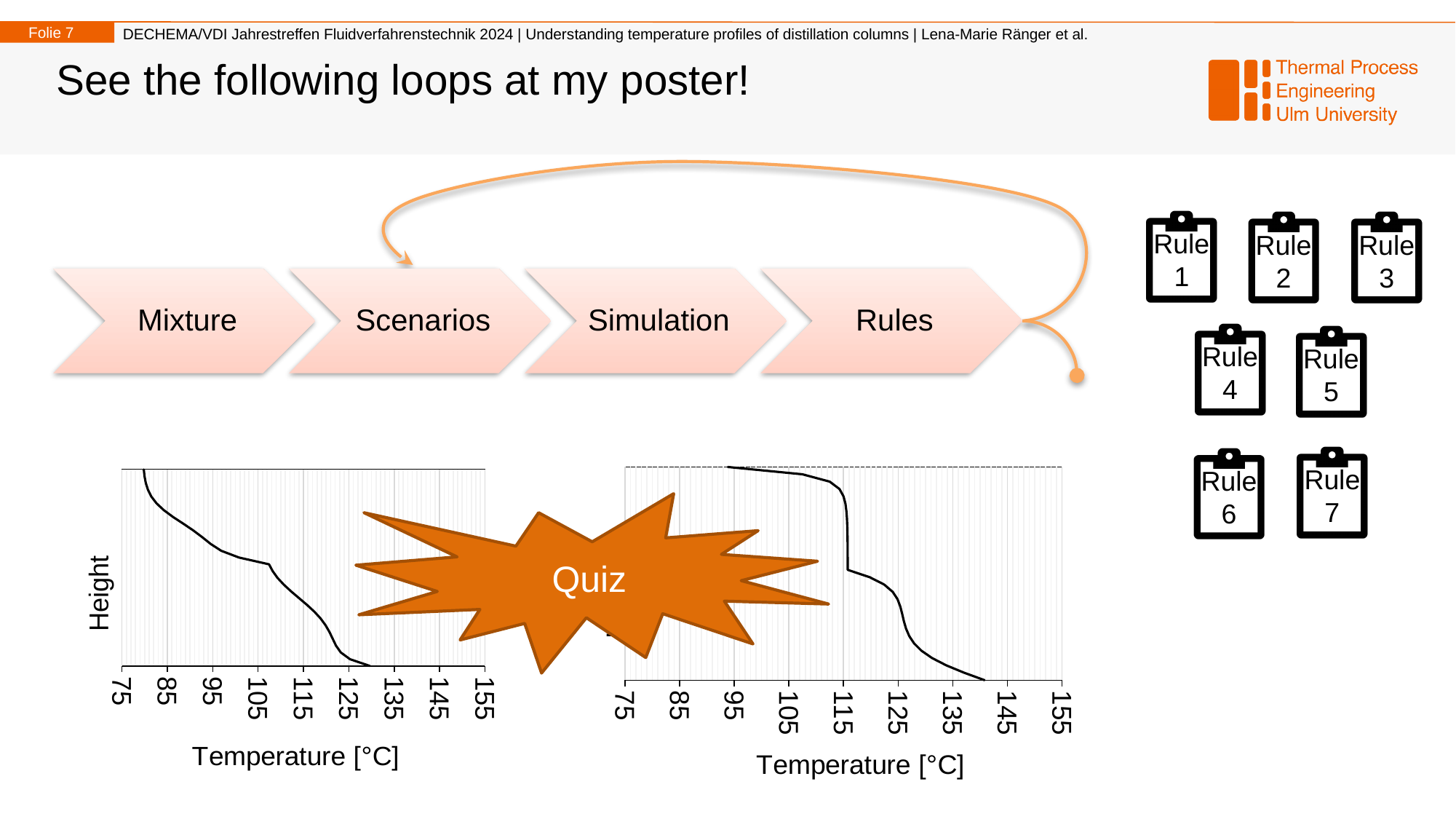
In the left chart, what is the lowest temperature tick shown on the x axis? 75 Which chart reaches a higher maximum temperature at the bottom of the column, the left chart or the right chart? right chart In the right chart, is the temperature at the bottom of the column (lowest height) greater or less than 135? greater In the right chart, what is the highest temperature tick shown on the x axis? 155 In the left chart, is the temperature at the bottom of the column (lowest height) greater or less than 125? greater How many temperature tick labels are shown on the x axis of the left chart? 9 In the left chart, is the temperature at the top of the column (highest height) greater or less than 85? less What is the x-axis label of the left chart? Temperature [°C] In the right chart, does the temperature increase or decrease when moving from the top of the column to the bottom? increase What kind of chart is the left chart at the bottom of the slide? line chart